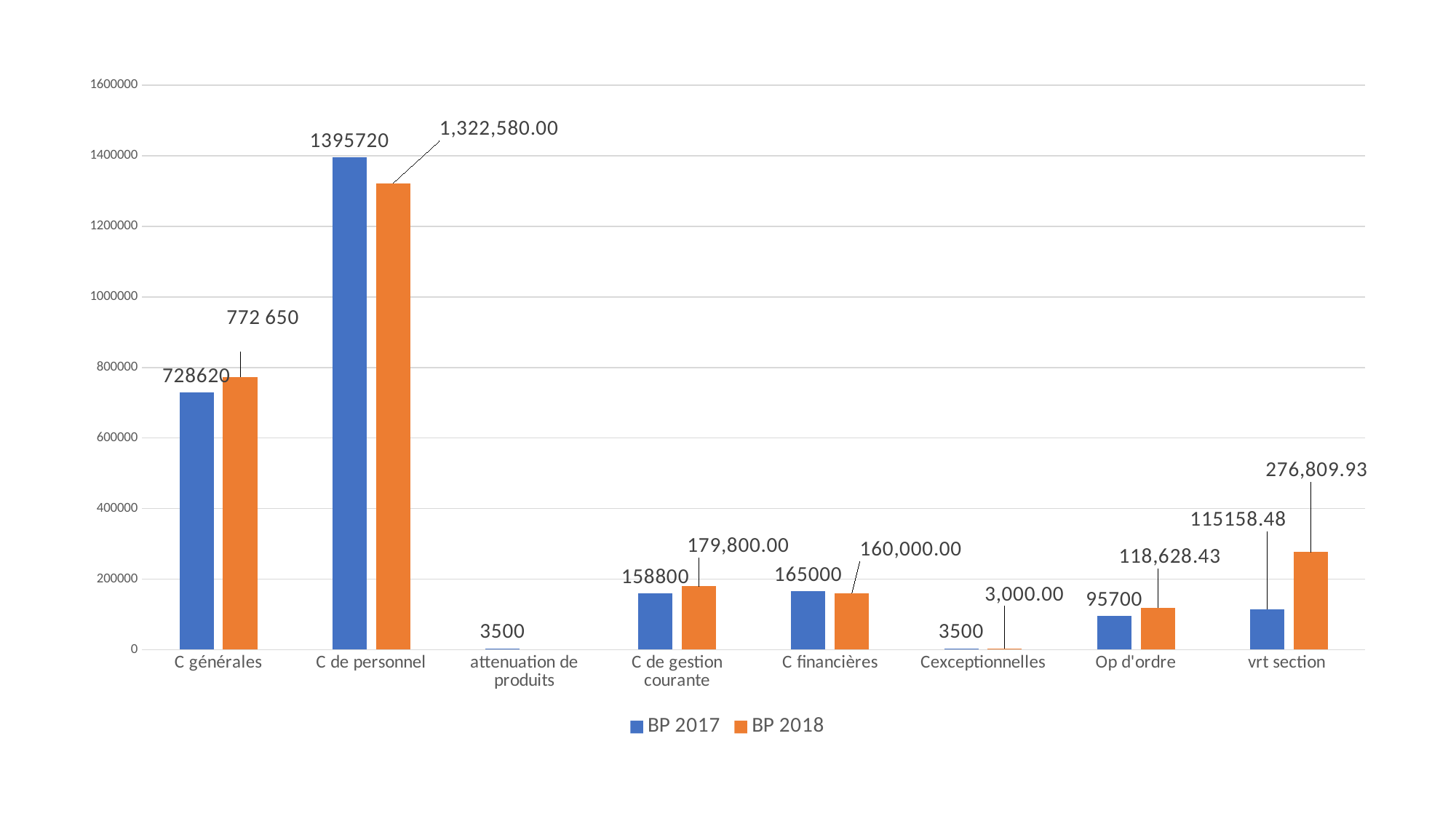
What is the BP 2018 value for Op d'ordre? 118,628.43 How many series does the legend list? 2 What kind of chart is shown on the slide? bar chart How many categories are shown on the x axis? 8 What is the BP 2018 value for vrt section? 276,809.93 Which category has the highest BP 2018 value? C de personnel Is the BP 2017 value for C générales greater or less than 800000? less Which category has the highest BP 2017 value? C de personnel What is the difference between the BP 2017 and BP 2018 values for C financières? 5000 What is the BP 2017 value for C générales? 728620 What is the BP 2017 value for C de personnel? 1395720 Which is larger for C de gestion courante, the BP 2017 value or the BP 2018 value? BP 2018